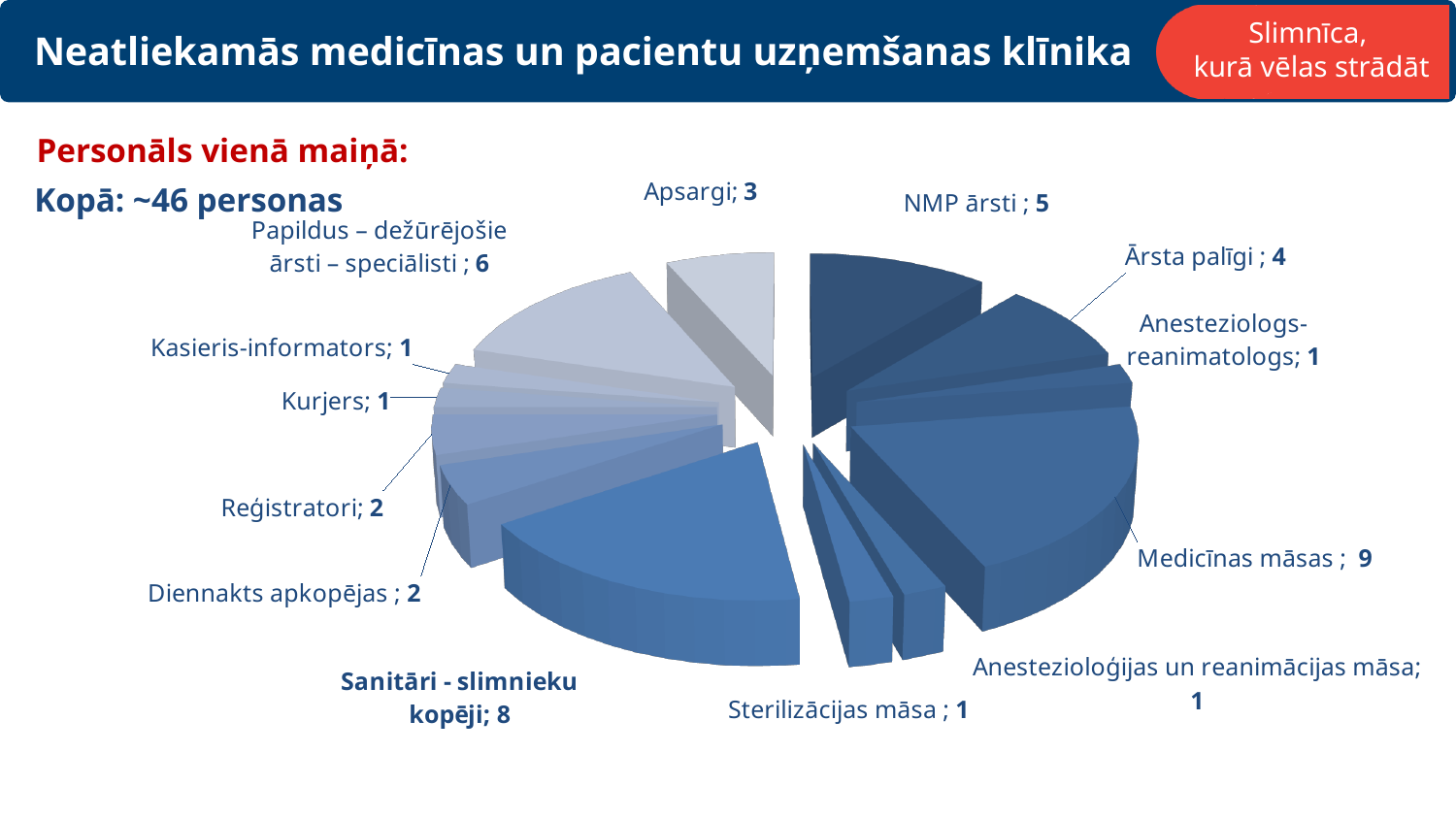
Which is larger, the value for Apsargi or the value for Reģistratori? Apsargi How many categories does the pie chart show? 13 What is the value for Papildus – dežūrējošie ārsti – speciālisti? 6 What kind of chart is shown on the slide? pie chart How many Medicīnas māsas are shown in the chart? 9 What is the value for NMP ārsti? 5 What is the value for Apsargi? 3 What is the value for Sanitāri - slimnieku kopēji? 8 Which category has the largest slice in the pie chart? Medicīnas māsas What is the difference between the values for Medicīnas māsas and Sanitāri - slimnieku kopēji? 1 What is the difference between the values for NMP ārsti and Ārsta palīgi? 1 According to the slide text, what is the approximate total number of personnel in one shift? ~46 personas